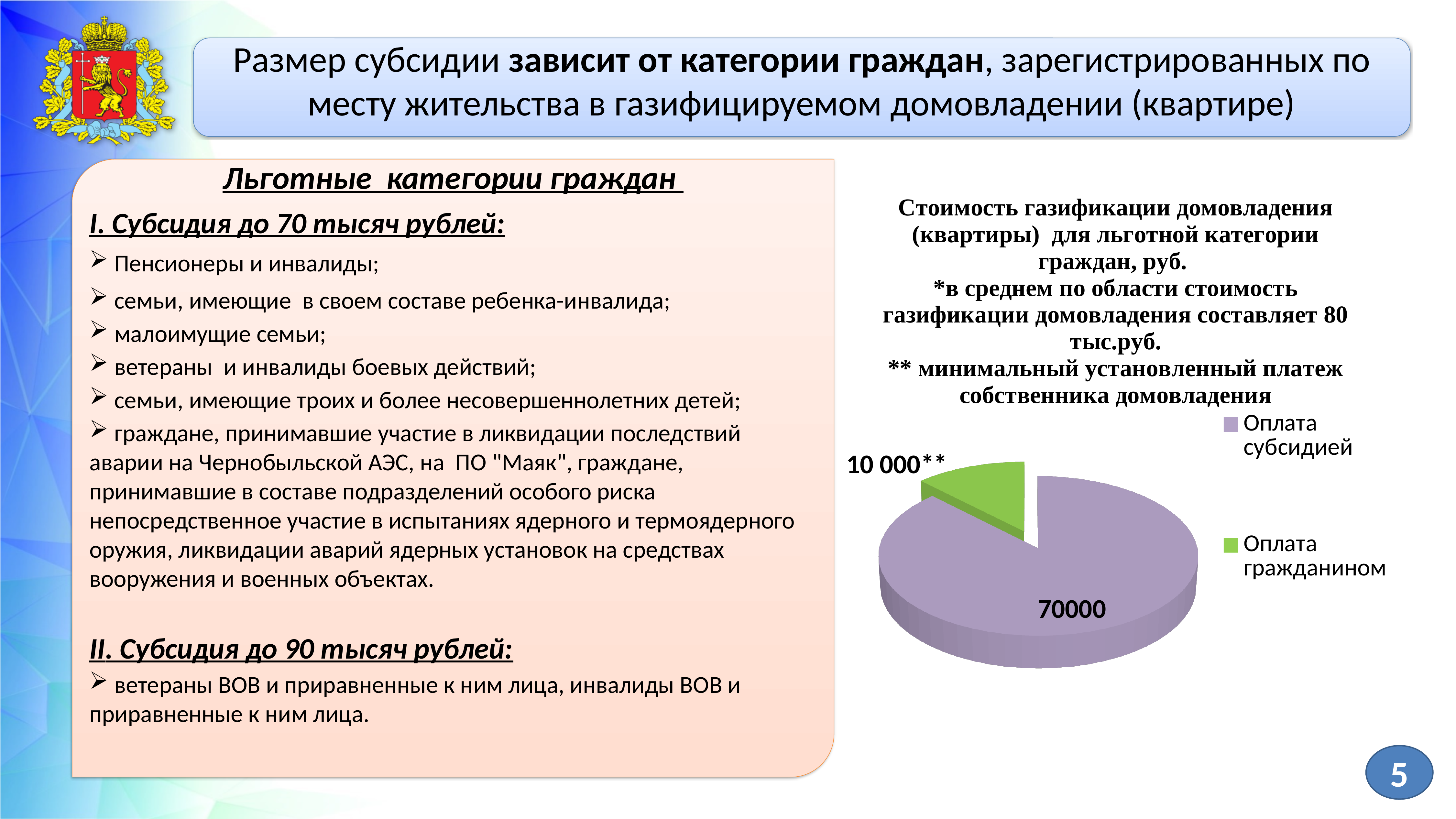
What is the value of the "Оплата субсидией" slice in the pie chart? 70000 What type of chart is shown on the slide? pie chart What is the value of the "Оплата гражданином" slice in the pie chart? 10 000 What is the total of the two values shown in the pie chart? 80000 Which slice of the pie chart is the largest? Оплата субсидией Which slice of the pie chart is the smallest? Оплата гражданином What share of the pie chart does the "Оплата гражданином" slice represent? 12.5% How many entries does the legend of the pie chart list? 2 Which is larger in the pie chart: "Оплата субсидией" or "Оплата гражданином"? Оплата субсидией How many slices does the pie chart have? 2 What is the difference between the "Оплата субсидией" and "Оплата гражданином" values in the pie chart? 60000 What colour is the "Оплата гражданином" slice in the pie chart? green